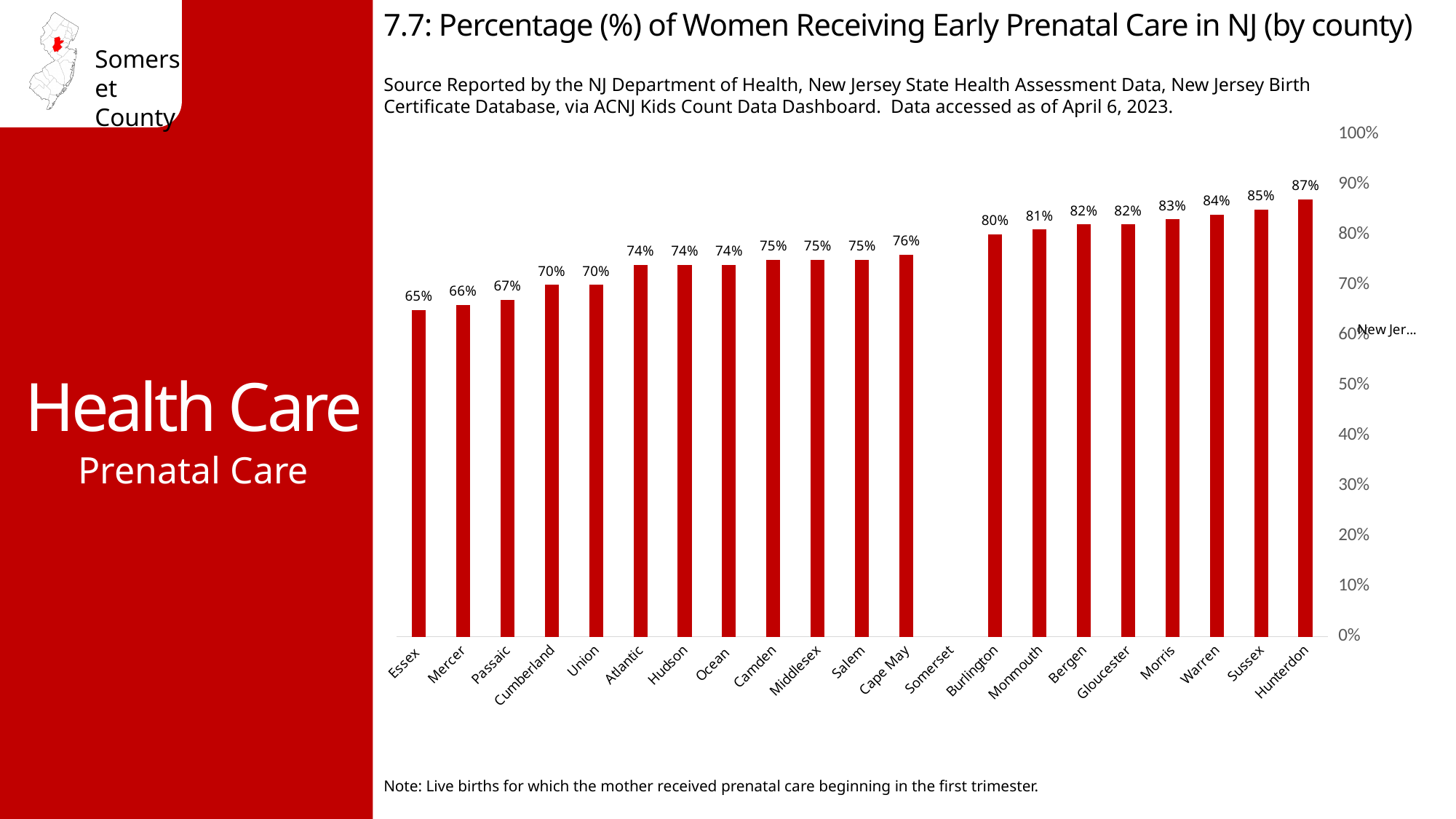
Which is larger, the value for Burlington or the value for Cape May? Burlington What is the value for Cape May? 76% How many county labels are shown on the x axis? 21 What is the value for Essex? 65% What is the difference between the values for Hunterdon and Essex? 22% What is the value for Hunterdon? 87% What kind of chart is shown? Bar chart Which county with a plotted bar has the lowest value? Essex Which county has the highest value? Hunterdon Which county on the x axis has no bar plotted? Somerset What is the value for Monmouth? 81% Is the value for Morris greater or less than 80%? greater